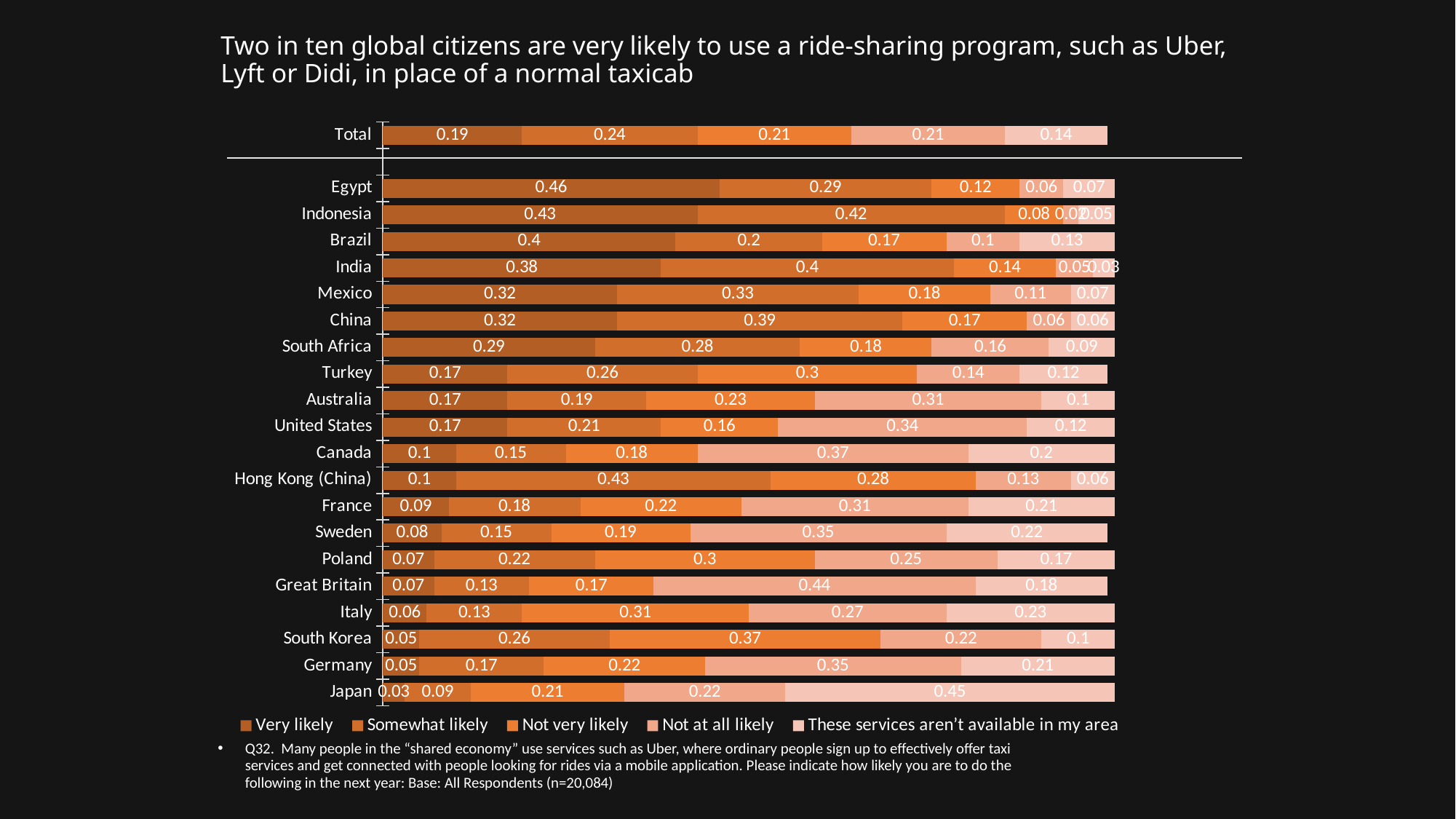
Which country has the lowest 'Very likely' value? Japan What is the difference between the 'Very likely' values for Egypt and Indonesia? 0.03 What is the 'Very likely' value for the Total bar? 0.19 What is the 'Not at all likely' value for Great Britain? 0.44 How many countries are listed below the Total bar? 20 What kind of chart is shown on the slide? Stacked bar chart What is the 'Very likely' value for Egypt? 0.46 How many series does the legend list? 5 Which country has the highest 'Very likely' value? Egypt What is the first entry in the chart's legend? Very likely What is the 'These services aren't available in my area' value for Japan? 0.45 Which is larger: the 'Not at all likely' value for Canada or for the United States? Canada